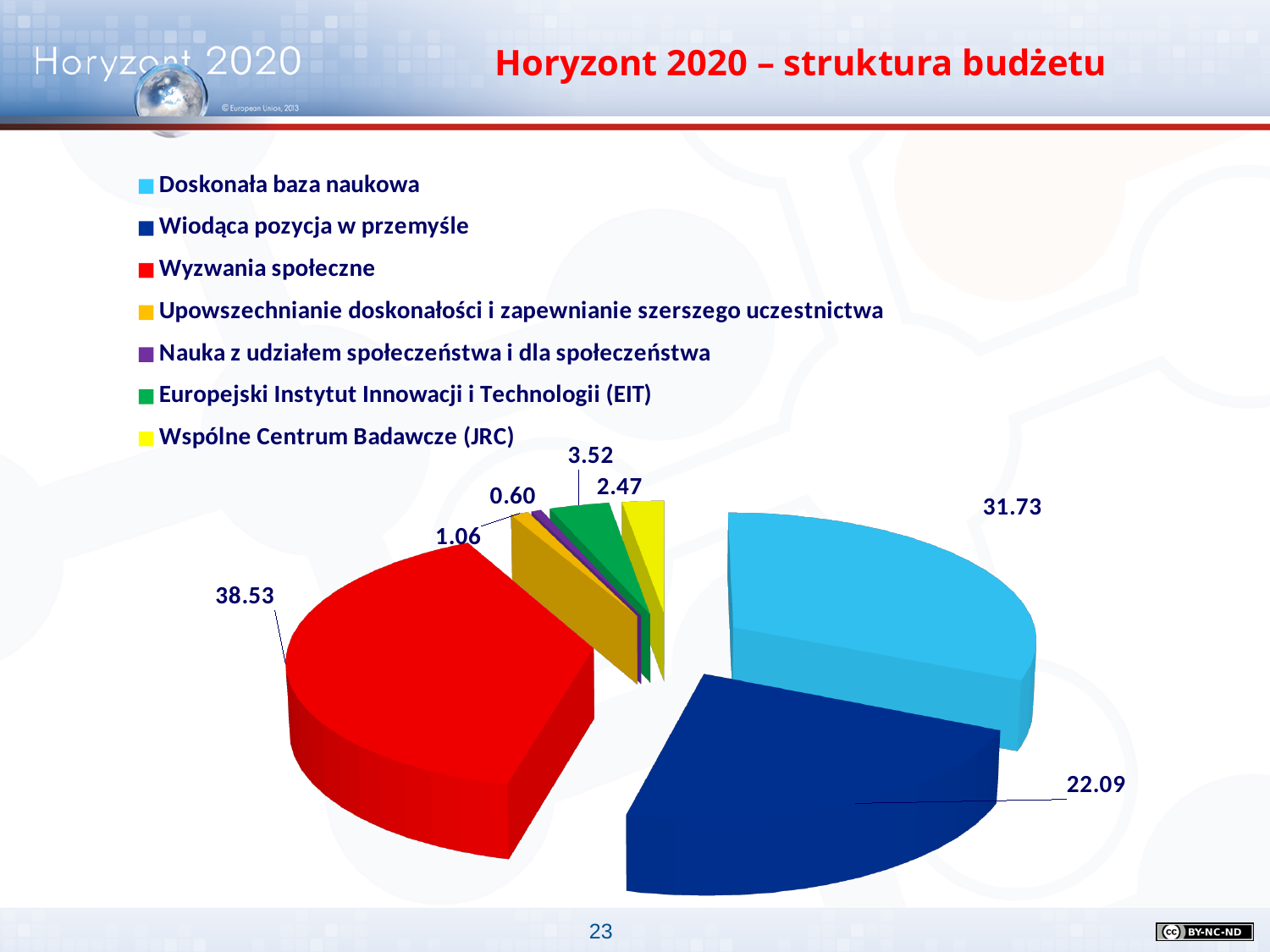
What is the difference between the values for Wyzwania społeczne and Doskonała baza naukowa? 6.80 What is the value for Doskonała baza naukowa? 31.73 Which category has the largest slice of the pie? Wyzwania społeczne How many slices does the pie chart have? 7 What colour is the slice for Wyzwania społeczne? Red What is the value for Wspólne Centrum Badawcze (JRC)? 2.47 Which is larger, the value for Upowszechnianie doskonałości i zapewnianie szerszego uczestnictwa or the value for Wspólne Centrum Badawcze (JRC)? Wspólne Centrum Badawcze (JRC) What type of chart is shown on the slide? Pie chart Which category has the smallest slice of the pie? Nauka z udziałem społeczeństwa i dla społeczeństwa What is the value for Wiodąca pozycja w przemyśle? 22.09 What is the title of the slide containing the chart? Horyzont 2020 – struktura budżetu What is the value for Europejski Instytut Innowacji i Technologii (EIT)? 3.52